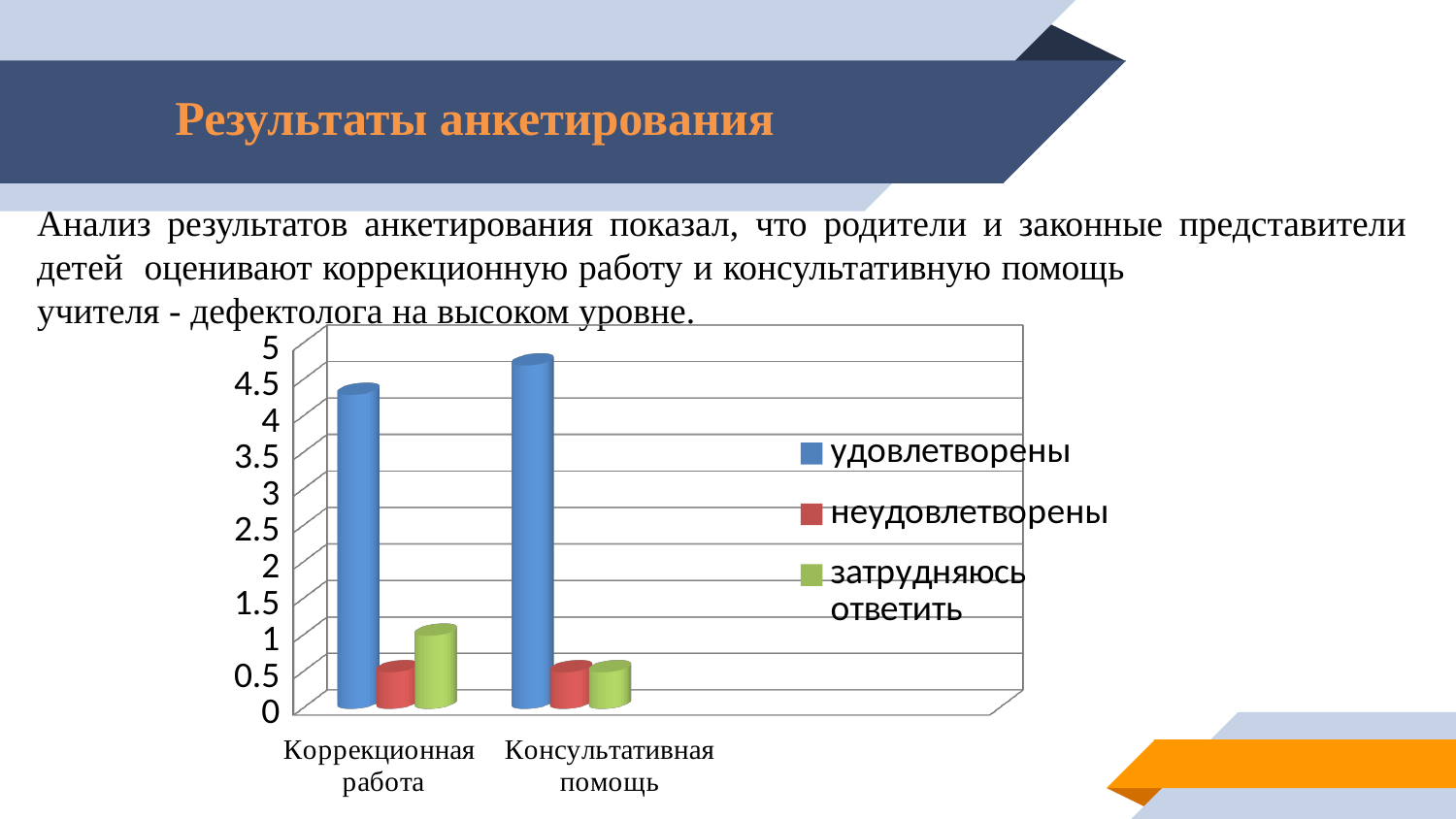
Is the value for затрудняюсь ответить in Коррекционная работа greater or less than 1.5? less Is the value for неудовлетворены in Коррекционная работа greater or less than 1? less What colour represents the удовлетворены series in the chart? blue What kind of chart is shown on the slide? bar chart How many categories are shown on the x axis of the chart? 2 Which category has the higher value for затрудняюсь ответить: Коррекционная работа or Консультативная помощь? Коррекционная работа Which category has the higher value for удовлетворены: Коррекционная работа or Консультативная помощь? Консультативная помощь Is the value for удовлетворены in Коррекционная работа greater or less than 4? greater How many series does the chart legend list? 3 Which series has the highest value in the Коррекционная работа category? удовлетворены Which series has the lowest value in the Коррекционная работа category? неудовлетворены